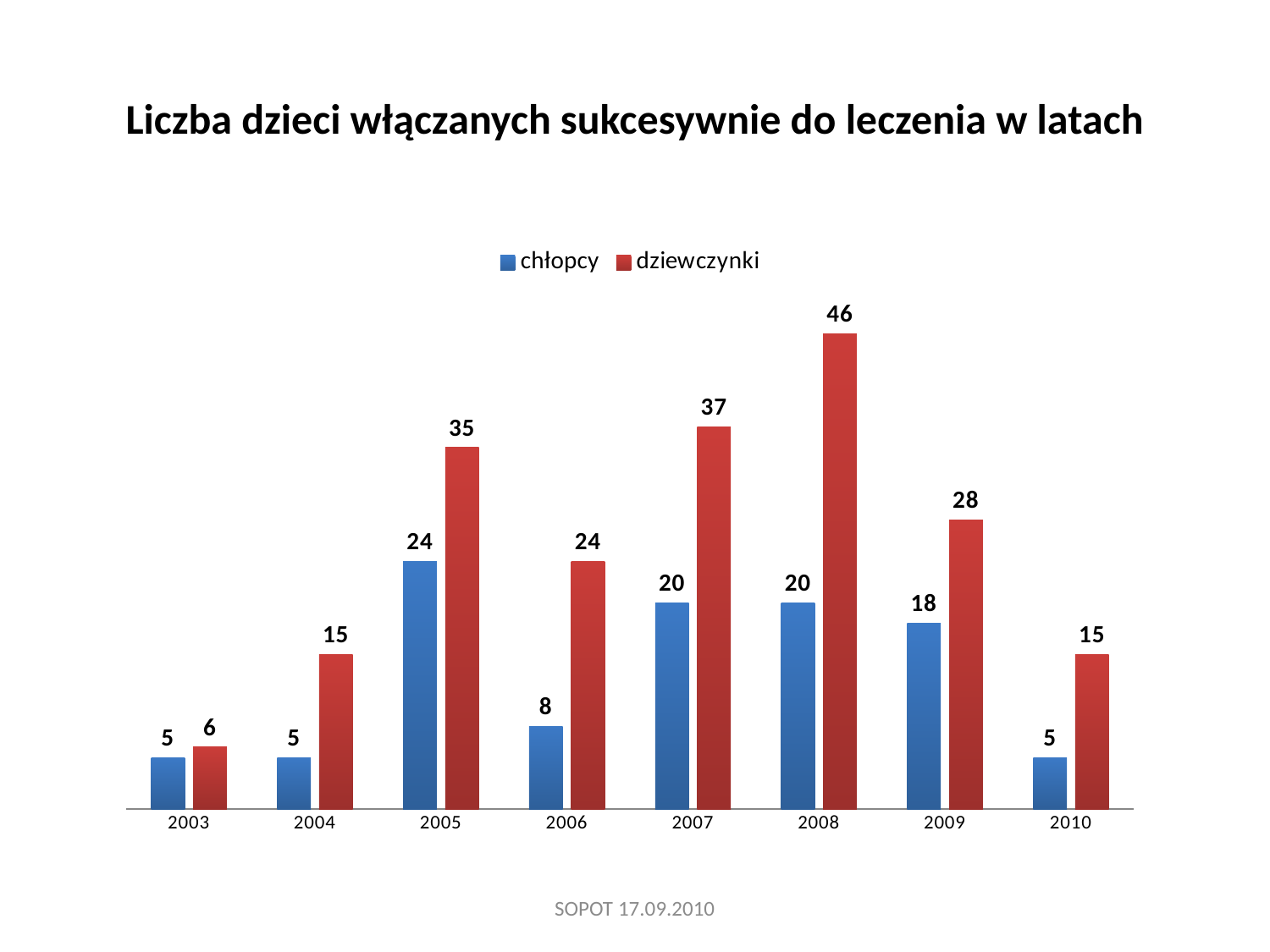
What kind of chart is shown on the slide? bar chart What is the total number of children (chłopcy plus dziewczynki) in 2009? 46 What colour are the bars for dziewczynki? red What is the value for dziewczynki in 2008? 46 How many years are shown on the x axis? 8 Which year has the highest value for dziewczynki? 2008 How many series does the legend list? 2 What is the value for chłopcy in 2005? 24 What is the value for dziewczynki in 2004? 15 What is the difference between dziewczynki and chłopcy in 2007? 17 Which year has the lowest value for chłopcy? 2003, 2004 and 2010 (all 5) Which is larger in 2006, chłopcy or dziewczynki? dziewczynki